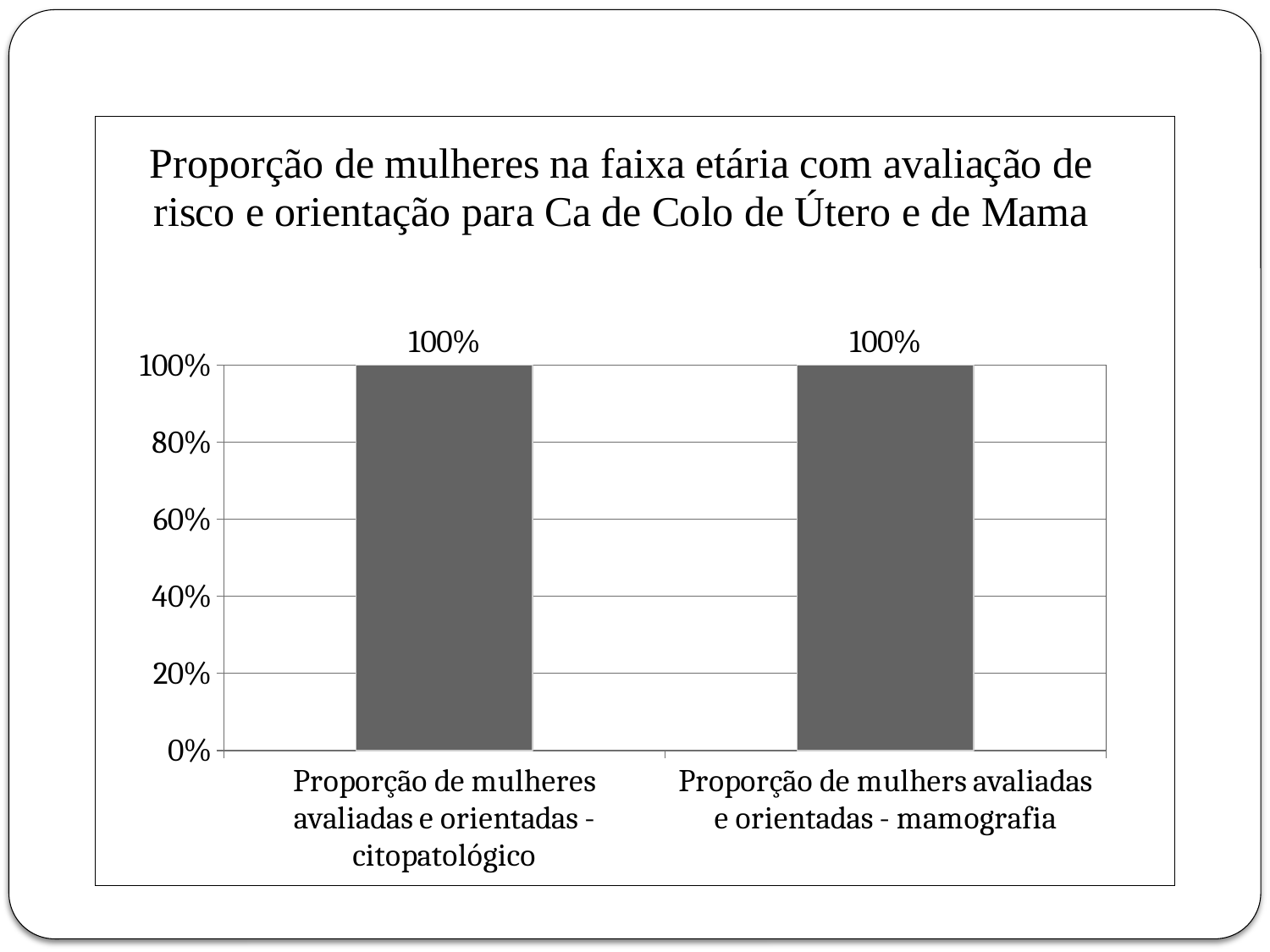
How many categories are shown on the x axis? 2 What kind of chart is shown on the slide? Bar chart What is the title of the chart? Proporção de mulheres na faixa etária com avaliação de risco e orientação para Ca de Colo de Útero e de Mama Is the value for the citopatológico category greater or less than 60%? greater What is the value for 'Proporção de mulhers avaliadas e orientadas - mamografia'? 100% Is the value for the mamografia category greater or less than 80%? greater What is the difference between the citopatológico value and the mamografia value? 0% Do the two bars have the same value? Yes What is the highest value shown on the y axis? 100% What is the value for 'Proporção de mulheres avaliadas e orientadas - citopatológico'? 100%